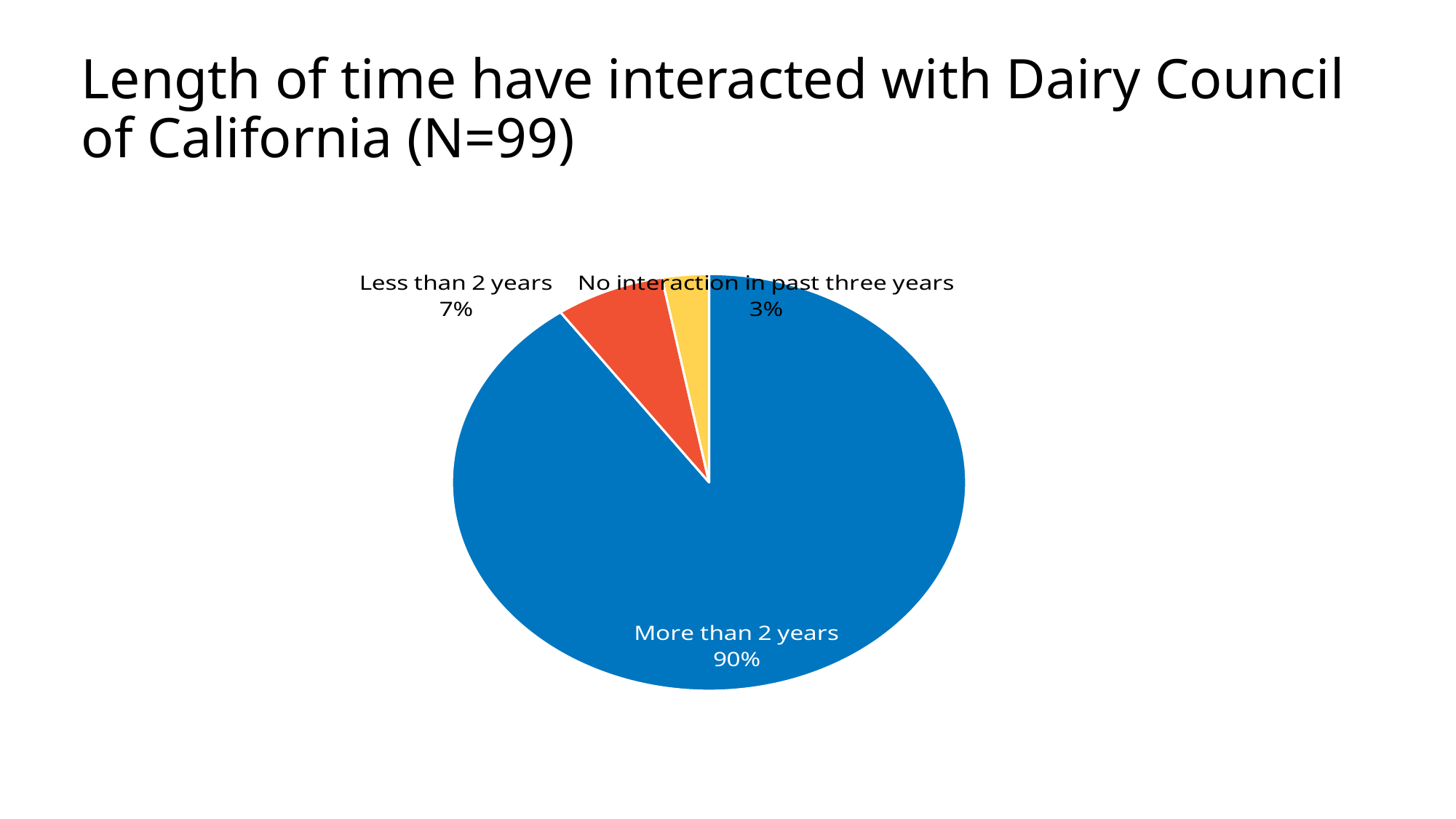
What colour is the 'More than 2 years' slice? blue What is the difference in percentage points between 'More than 2 years' and 'Less than 2 years'? 83 What share of the pie is 'More than 2 years'? 90% What is the sample size (N) stated in the slide title? 99 What kind of chart is shown on the slide? pie chart What share of the pie is 'Less than 2 years'? 7% Which category has the smallest slice of the pie? No interaction in past three years How many slices does the pie chart have? 3 Which category has the largest slice of the pie? More than 2 years What is the difference in percentage points between 'Less than 2 years' and 'No interaction in past three years'? 4 What share of the pie is 'No interaction in past three years'? 3% Which is larger: the share for 'Less than 2 years' or for 'No interaction in past three years'? Less than 2 years